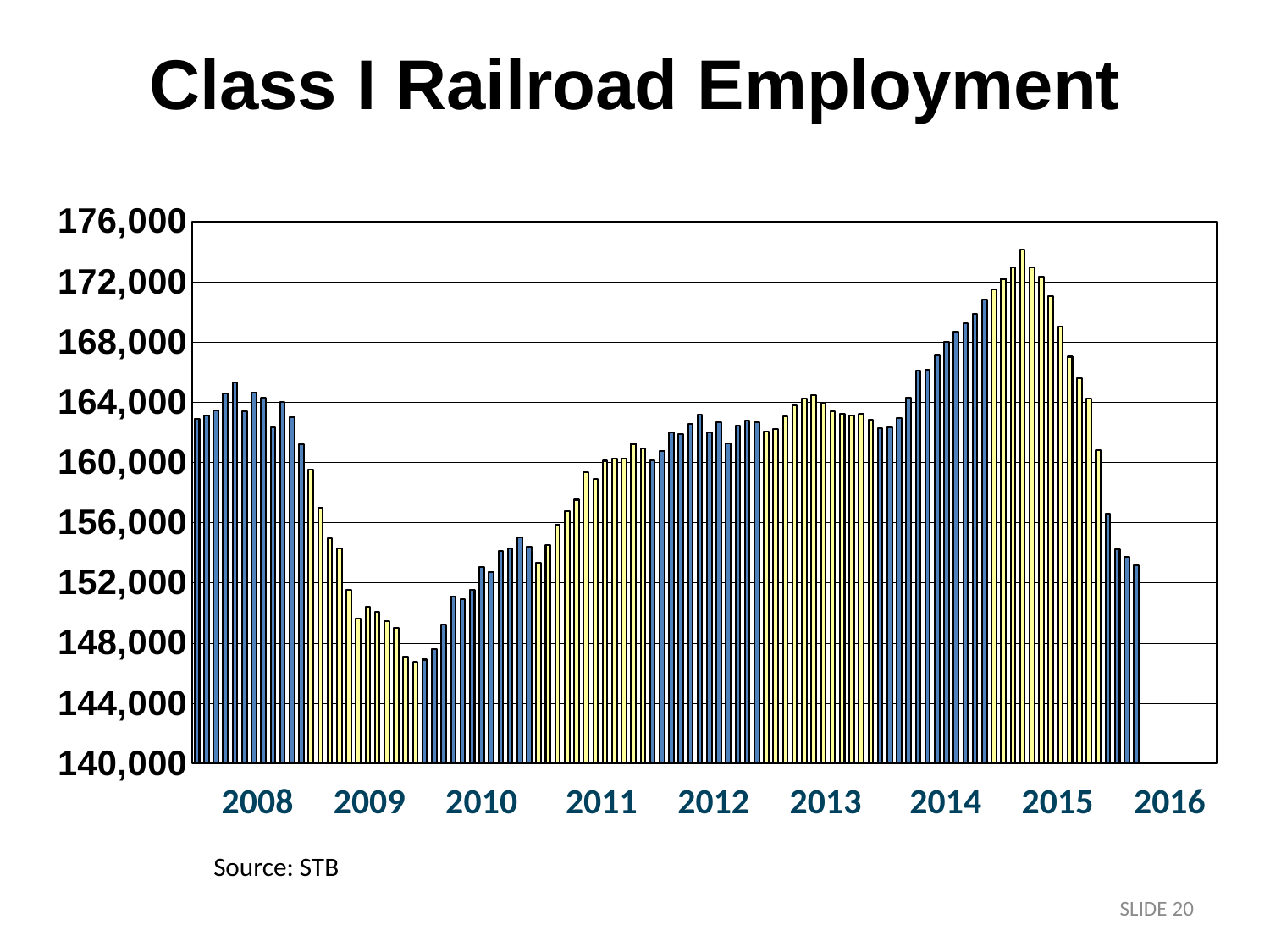
What source is cited for the chart data? STB Is the last employment value shown in 2016 greater or less than 156,000? less Does employment rise or fall from 2009 to 2014? Rise Is the peak employment value in 2015 greater or less than 172,000? greater Is the employment value at the start of 2008 greater or less than 160,000? greater In which year labeled on the x axis does employment reach its lowest level? 2009 In which year labeled on the x axis does employment reach its highest level? 2015 What is the title of the chart? Class I Railroad Employment What kind of chart is shown on the slide? Bar chart How many year labels appear on the x axis? 9 Does employment rise or fall from the 2015 peak to 2016? Fall